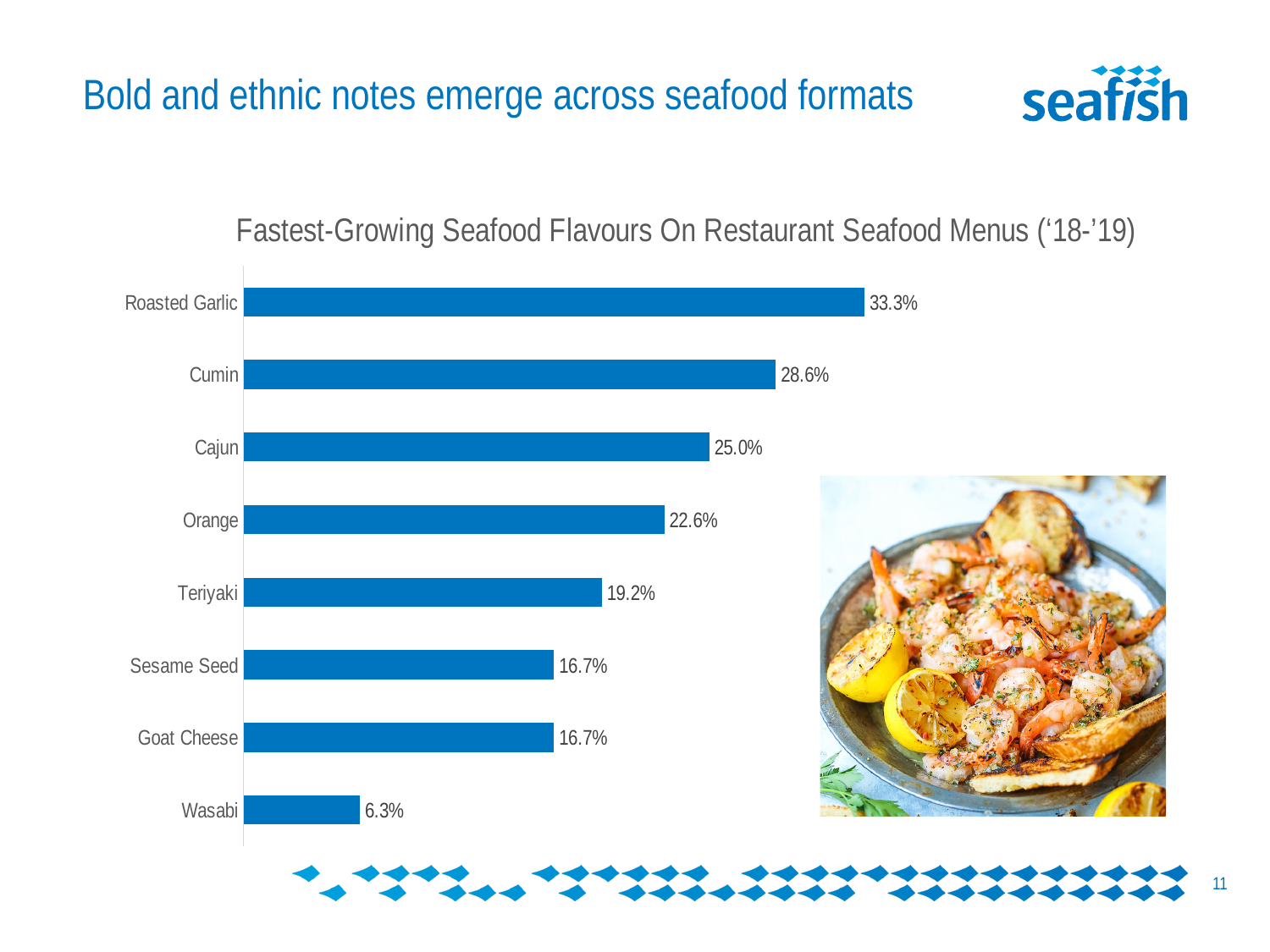
What is the difference between the values for Cumin and Cajun? 3.6% Which two flavours share the same value of 16.7%? Sesame Seed and Goat Cheese How many flavours are shown in the chart? 8 Which is larger, the value for Orange or the value for Teriyaki? Orange What is the value for Roasted Garlic? 33.3% What is the title of the chart? Fastest-Growing Seafood Flavours On Restaurant Seafood Menus ('18-'19) What is the value for Wasabi? 6.3% What kind of chart is shown on the slide? Bar chart What is the value for Teriyaki? 19.2% What is the difference between the values for Roasted Garlic and Wasabi? 27.0% Which flavour has the highest value? Roasted Garlic Which flavour has the lowest value? Wasabi